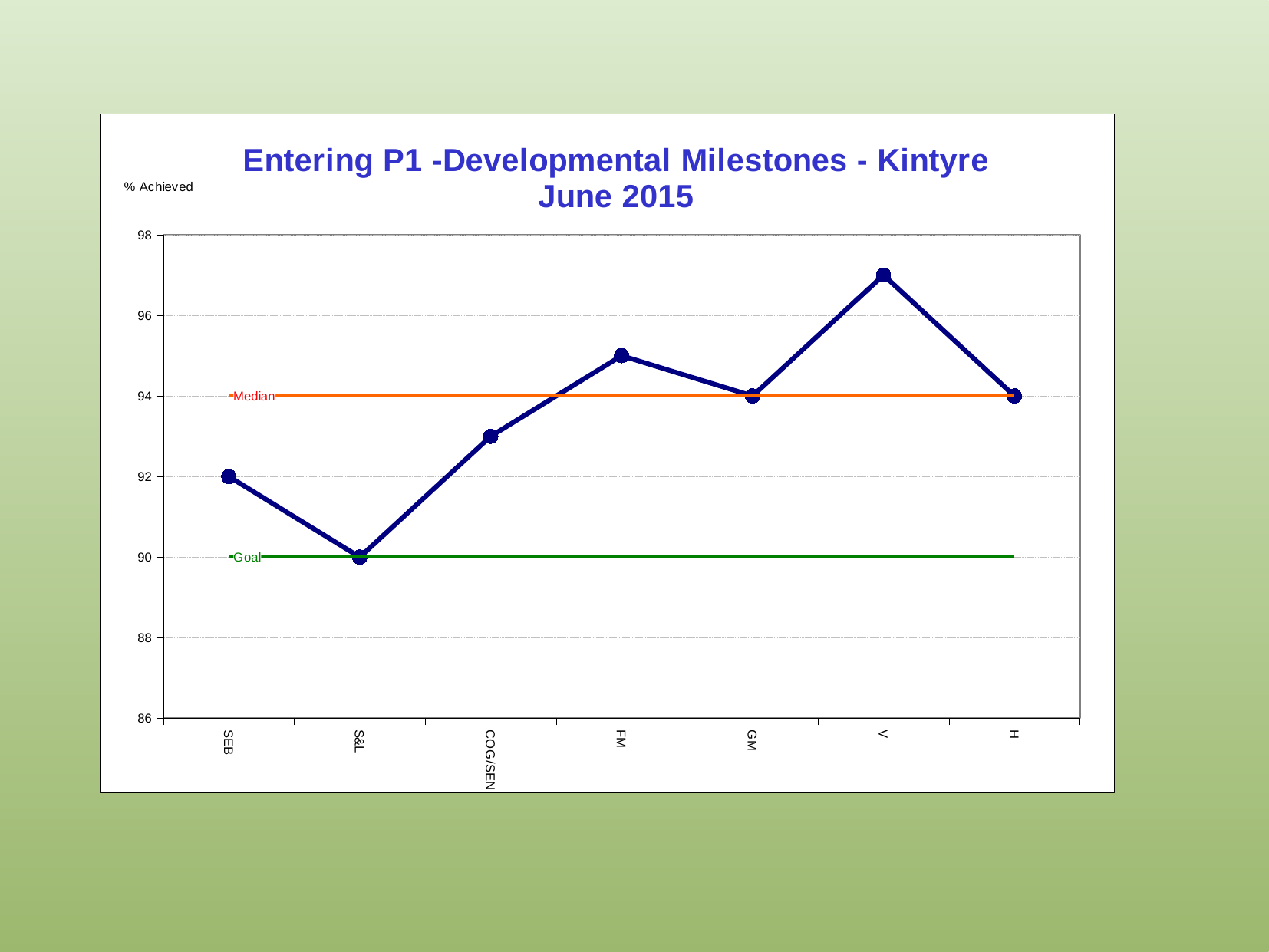
Which category has the highest % Achieved? V What value does the Goal line sit at? 90 What is the % Achieved value for S&L? 90 What is the title of the chart? Entering P1 -Developmental Milestones - Kintyre June 2015 How many categories are plotted along the x axis? 7 What is the % Achieved value for SEB? 92 Which category has the lowest % Achieved? S&L What value does the Median line sit at? 94 Is the value for COG/SEN greater or less than 94? less What kind of chart is shown on the slide? line chart Which is larger, the value for FM or the value for GM? FM